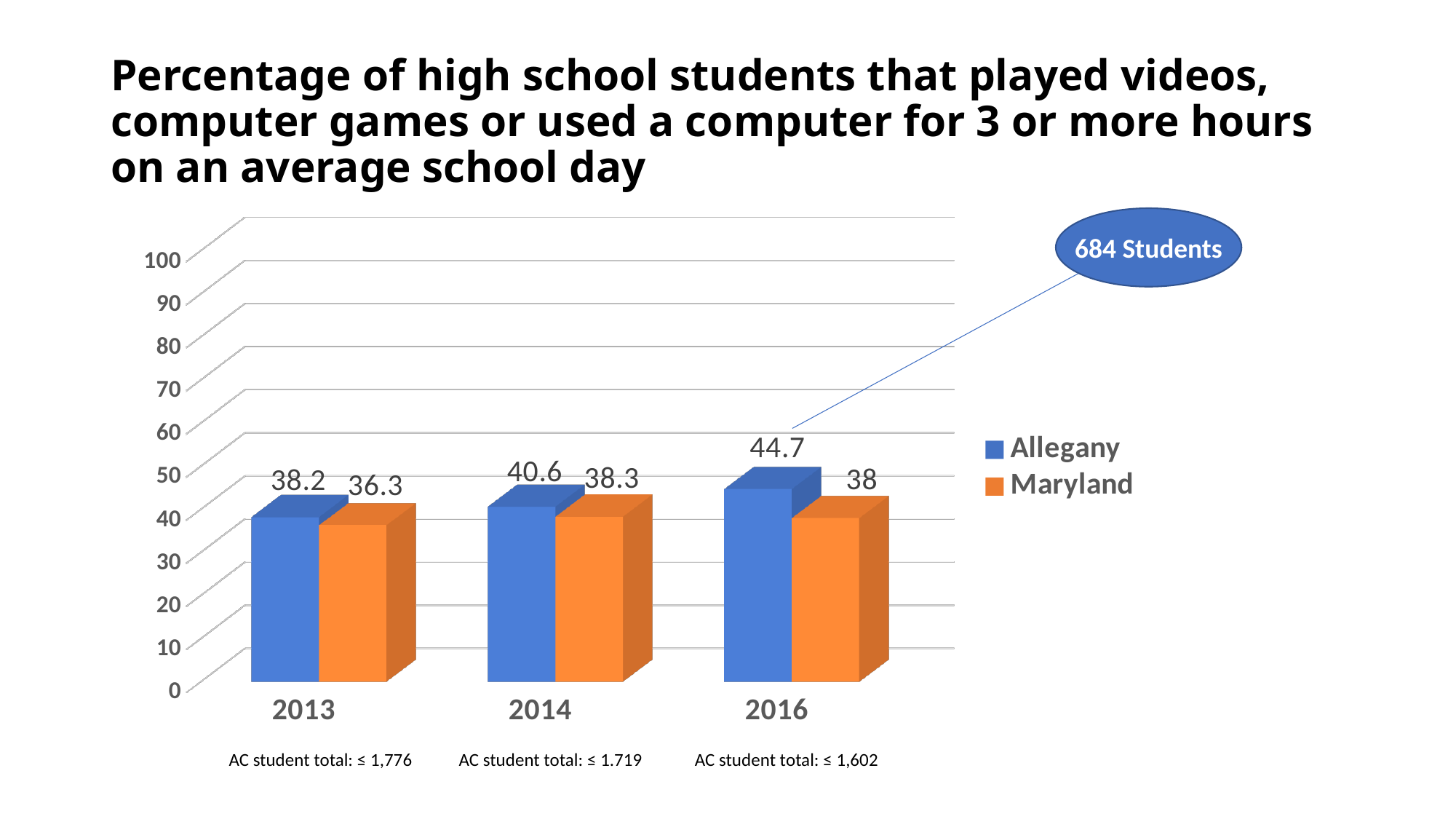
What is the value for Allegany in 2014? 40.6 What is the value for Maryland in 2016? 38 What is the value for Allegany in 2013? 38.2 What is the difference between the Allegany and Maryland values in 2016? 6.7 What kind of chart is shown on the slide? Bar chart How many years are shown on the x axis? 3 Which is larger in 2014, the Allegany value or the Maryland value? Allegany Do the Allegany values rise or fall from 2013 to 2016? Rise In which year is the Allegany value highest? 2016 How many series does the legend list? 2 In which year is the Maryland value lowest? 2013 What does the callout bubble pointing to the 2016 Allegany bar say? 684 Students